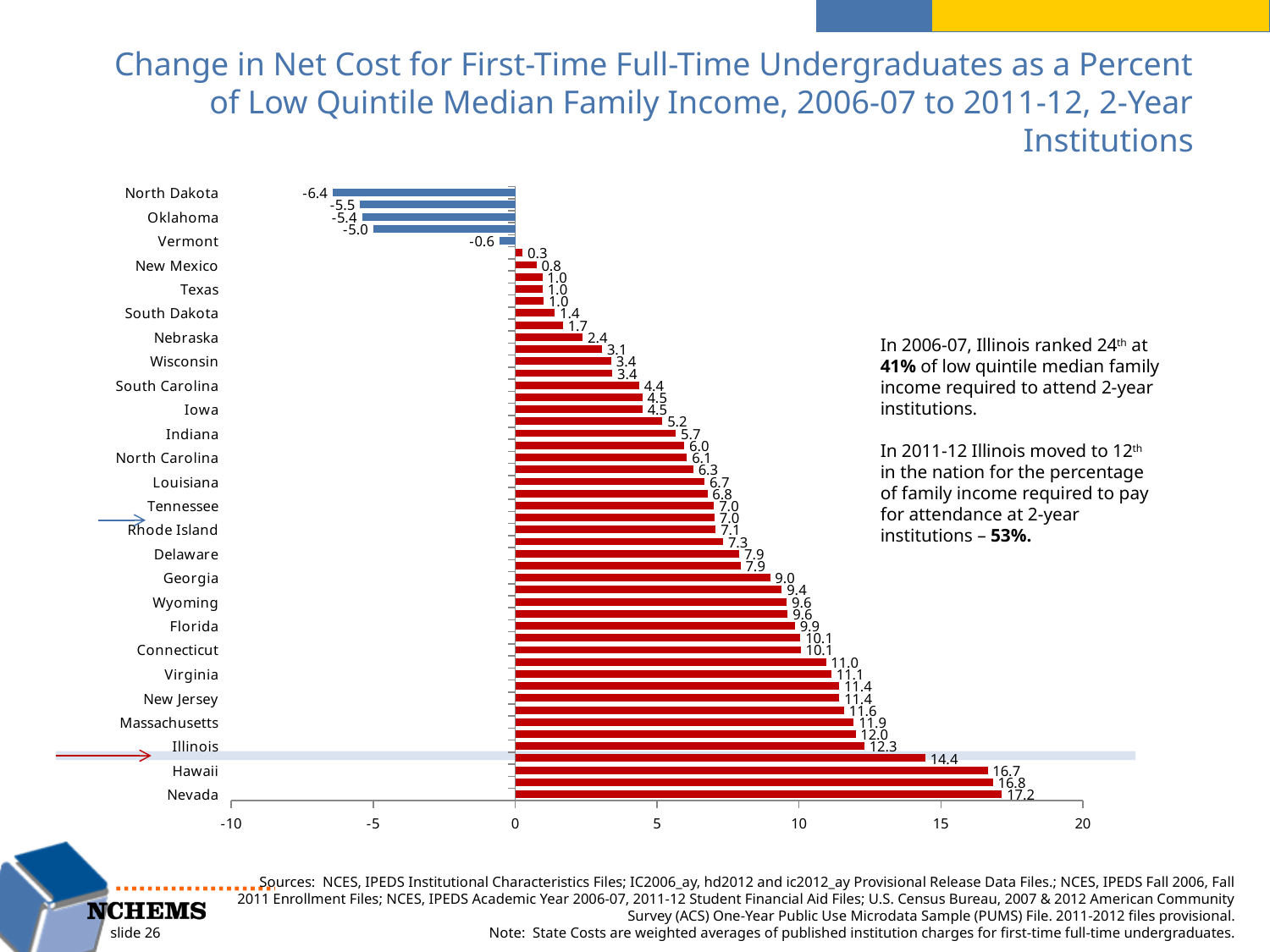
What is the value for Nevada? 17.2 What colour are the bars with negative values? Blue Which state has the lowest value in the chart? North Dakota Which has the larger value, Nevada or North Dakota? Nevada Is the value for Georgia greater or less than 5? greater What is the value for North Dakota? -6.4 What type of chart is shown on the slide? Bar chart Is the value for Texas greater or less than 5? less What is the difference between the values for Nevada and North Dakota? 23.6 Is the value for Illinois greater or less than 10? greater Which state has the highest value in the chart? Nevada